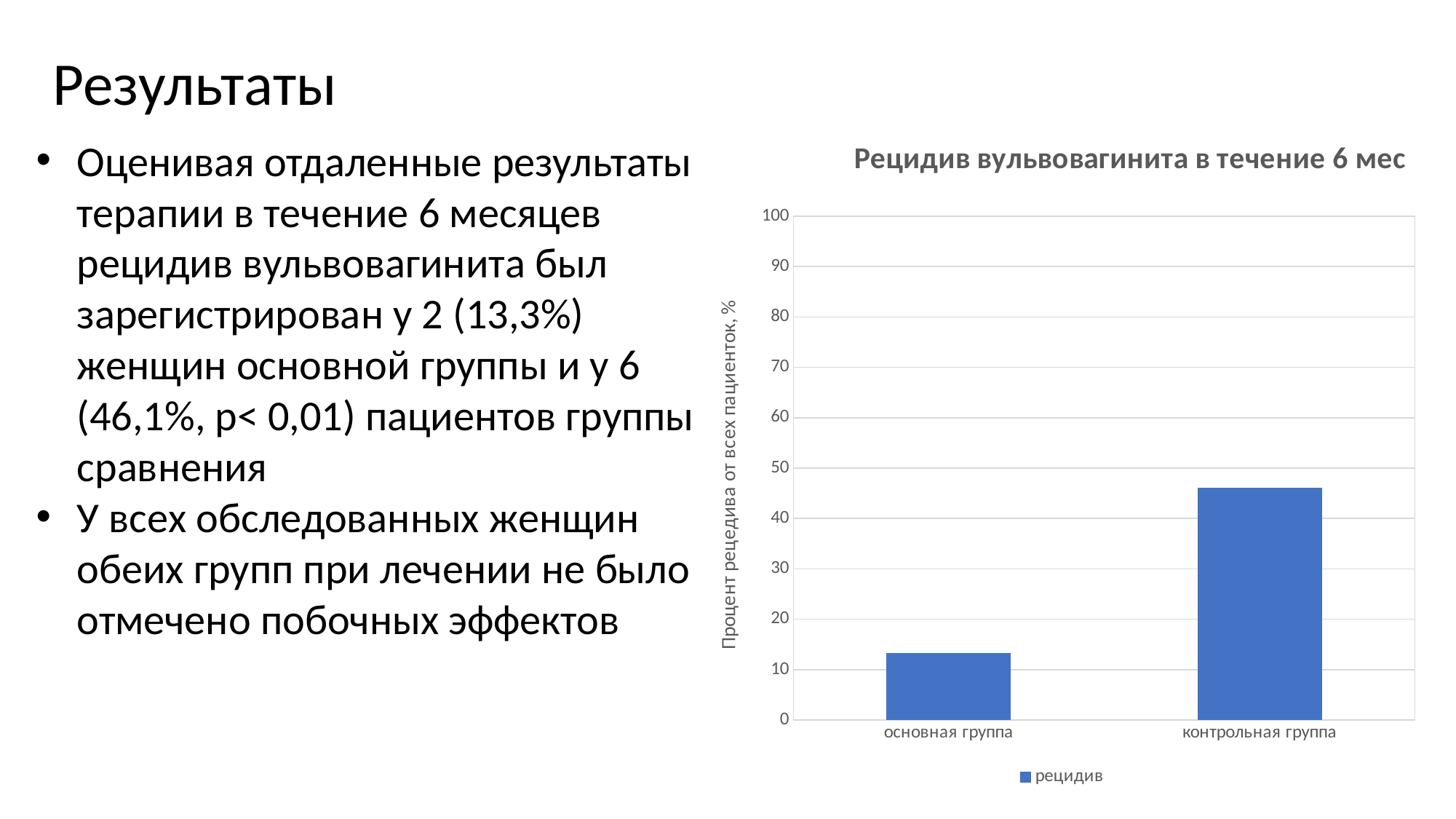
Do the values rise or fall from основная группа to контрольная группа along the x axis? rise How many series does the chart legend list? 1 Is the value for основная группа greater or less than 20? less What kind of chart is shown on the slide? bar chart What is the name of the series shown in the chart legend? рецидив Is the value for контрольная группа greater or less than 50? less What is the title of the chart? Рецидив вульвовагинита в течение 6 мес Which group has the lowest recurrence rate in the chart? основная группа Which group has the highest recurrence rate in the chart? контрольная группа Is the value for контрольная группа greater or less than 40? greater Which is larger: the value for основная группа or the value for контрольная группа? контрольная группа How many categories are shown on the x axis of the chart? 2